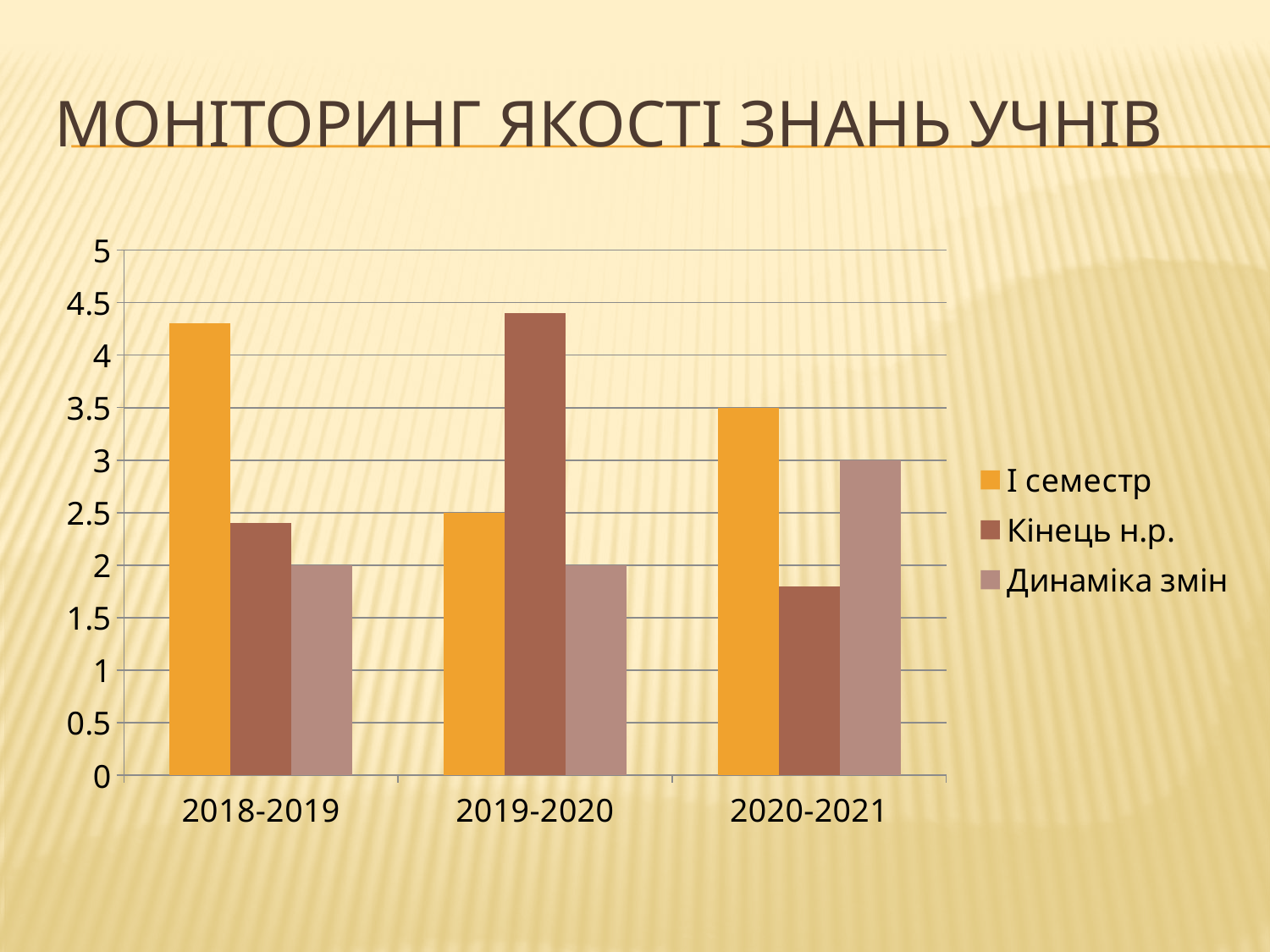
How many categories are shown on the x axis? 3 In which year is the value of І семестр lowest? 2019-2020 What is the value of Динаміка змін for 2018-2019? 2 What is the difference between the Динаміка змін values for 2020-2021 and 2018-2019? 1 Is the value of І семестр for 2018-2019 greater or less than 4? greater What is the value of І семестр for 2019-2020? 2.5 In which year is the value of Кінець н.р. highest? 2019-2020 What kind of chart is shown on the slide? bar chart How many series does the legend list? 3 Is the value of Кінець н.р. for 2020-2021 greater or less than 2? less What is the value of Динаміка змін for 2020-2021? 3 For 2018-2019, which is larger: І семестр or Кінець н.р.? І семестр